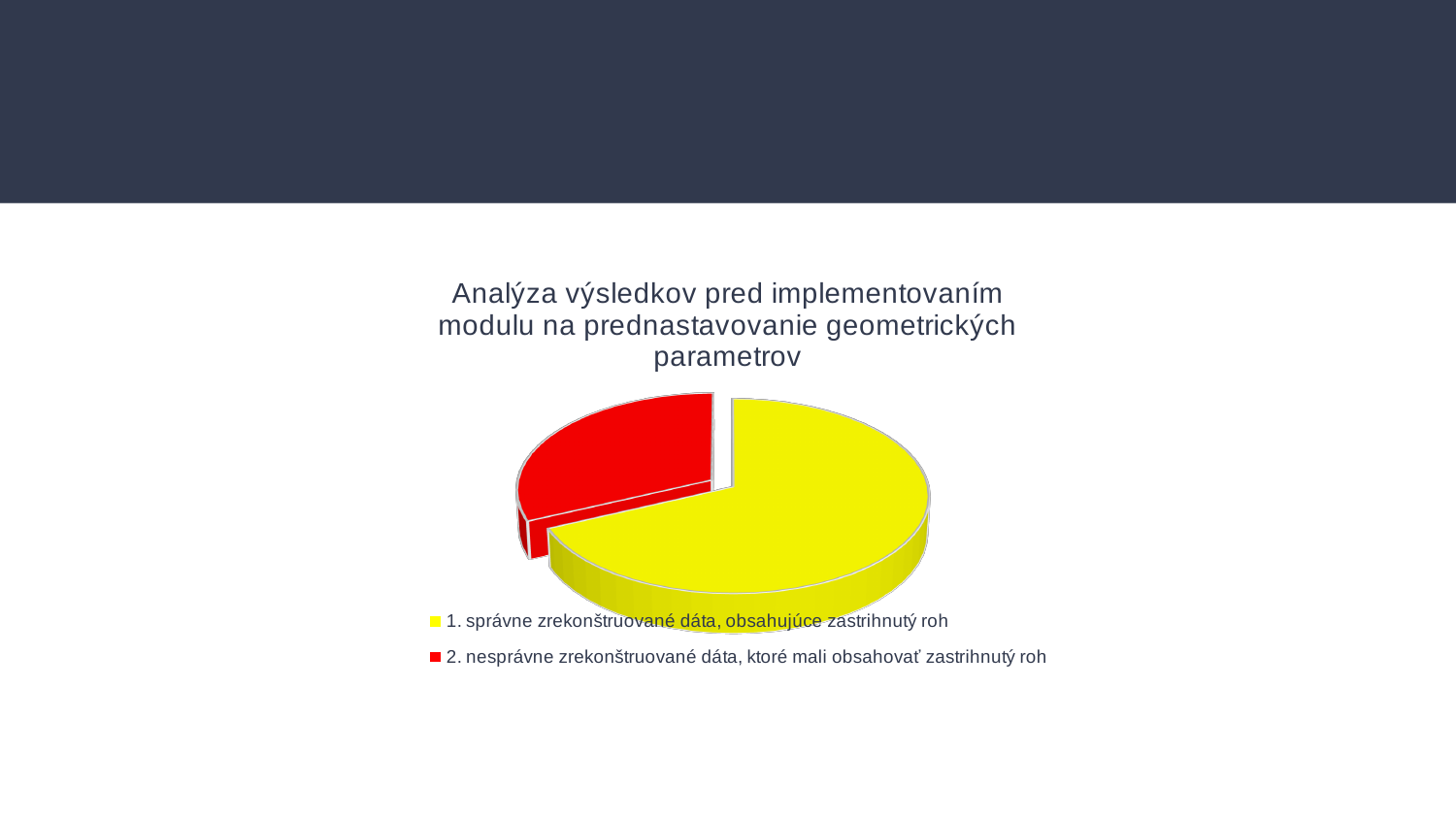
Which slice is larger: the yellow one or the red one? the yellow one What is the title of the pie chart? Analýza výsledkov pred implementovaním modulu na prednastavovanie geometrických parametrov Which category has the largest slice in the pie chart? 1. správne zrekonštruované dáta, obsahujúce zastrihnutý roh What colour represents '2. nesprávne zrekonštruované dáta, ktoré mali obsahovať zastrihnutý roh' in the pie chart? red How many entries does the legend of the pie chart list? 2 How many slices does the pie chart have? 2 Is the slice for '1. správne zrekonštruované dáta, obsahujúce zastrihnutý roh' larger or smaller than the slice for '2. nesprávne zrekonštruované dáta, ktoré mali obsahovať zastrihnutý roh'? larger What kind of chart is shown on the slide? pie chart Which category has the smallest slice in the pie chart? 2. nesprávne zrekonštruované dáta, ktoré mali obsahovať zastrihnutý roh